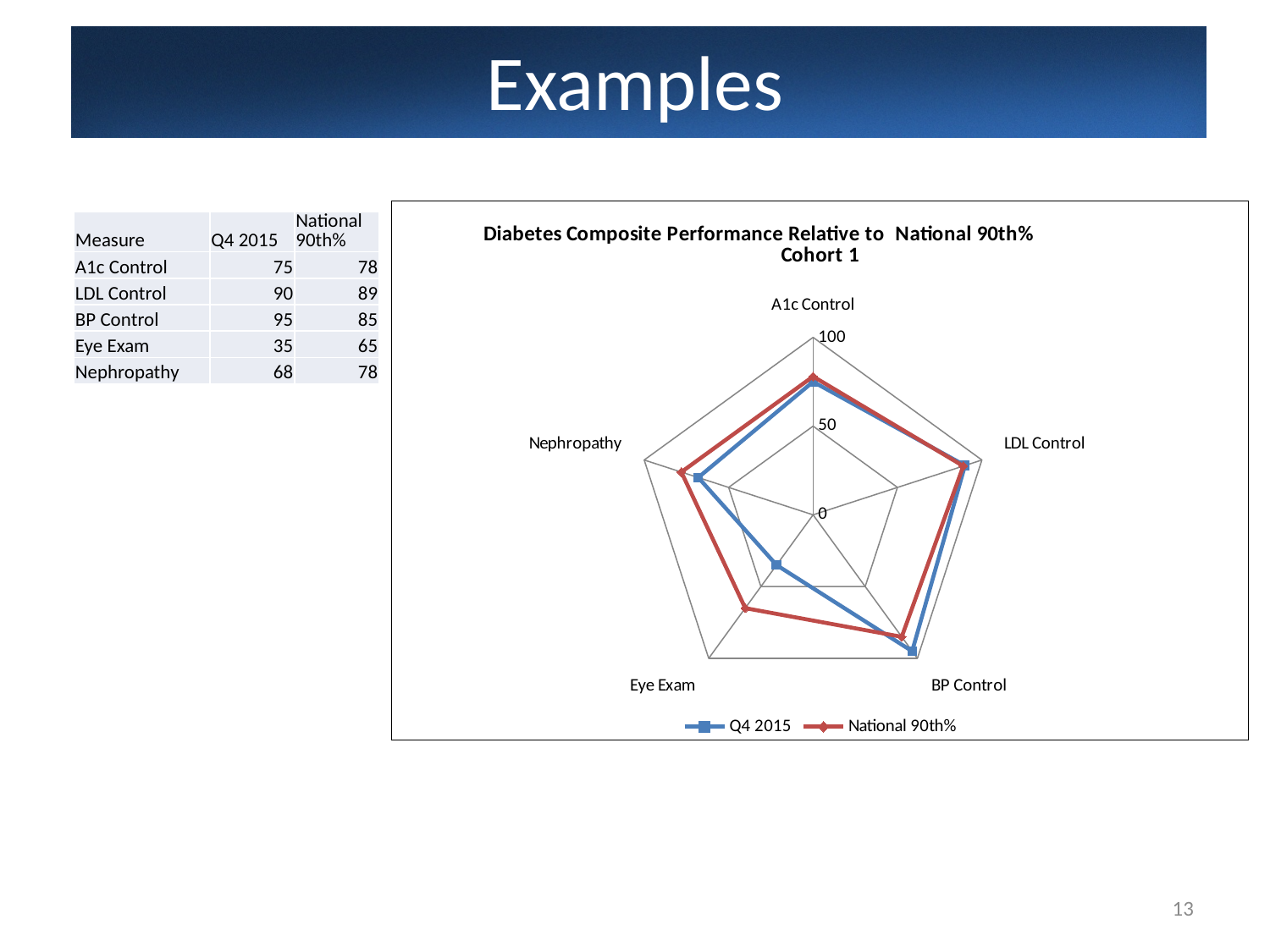
What is the Q4 2015 value for Eye Exam? 35 What is the Q4 2015 value for Nephropathy? 68 How many measures (axes) are plotted on the radar chart? 5 For BP Control, which is larger: the Q4 2015 value or the National 90th% value? Q4 2015 How many series does the chart legend list? 2 What is the difference between the National 90th% and Q4 2015 values for Eye Exam? 30 Is the Q4 2015 value for Eye Exam greater or less than 50? less Which measure has the highest Q4 2015 value? BP Control Which measure has the lowest Q4 2015 value? Eye Exam What is the title of the chart? Diabetes Composite Performance Relative to National 90th% Cohort 1 What is the National 90th% value for BP Control? 85 What kind of chart is shown on the slide? Radar chart